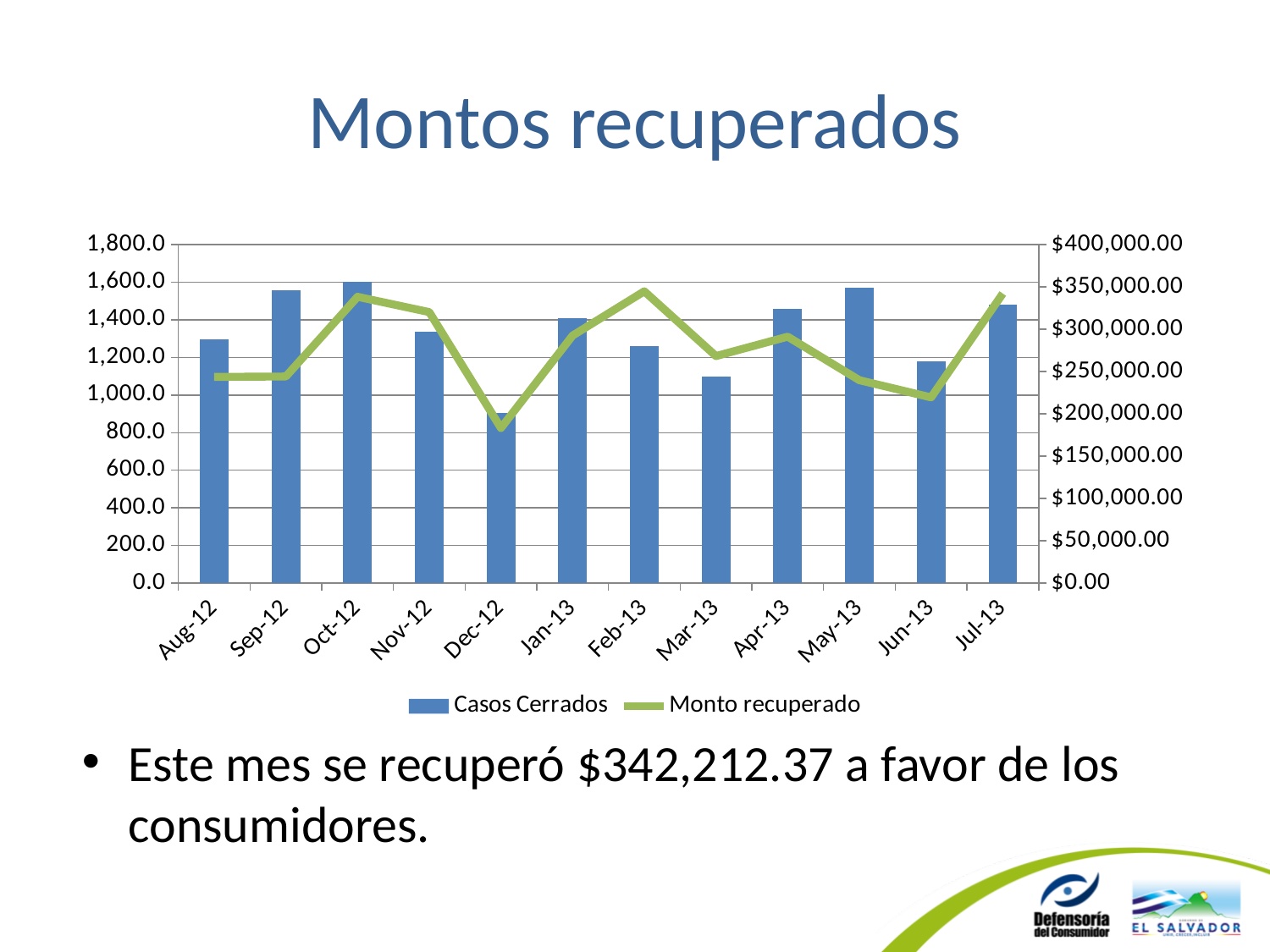
How many months are shown on the x axis? 12 How many series does the legend list? 2 Is the value for Monto recuperado in Oct-12 greater or less than $300,000.00? greater Is the value for Monto recuperado in Jun-13 greater or less than $250,000.00? less Which month has the lowest value for Casos Cerrados? Dec-12 Which month has the lowest value for Monto recuperado? Dec-12 Which is larger, Casos Cerrados in Sep-12 or in Dec-12? Sep-12 What kind of chart is shown on the slide? A combined bar and line chart What is the title of the chart? Montos recuperados Which month has the highest value for Casos Cerrados? Oct-12 Is the value for Casos Cerrados in Dec-12 greater or less than 1,000.0? less Do the Casos Cerrados values rise or fall from Sep-12 to Dec-12? fall